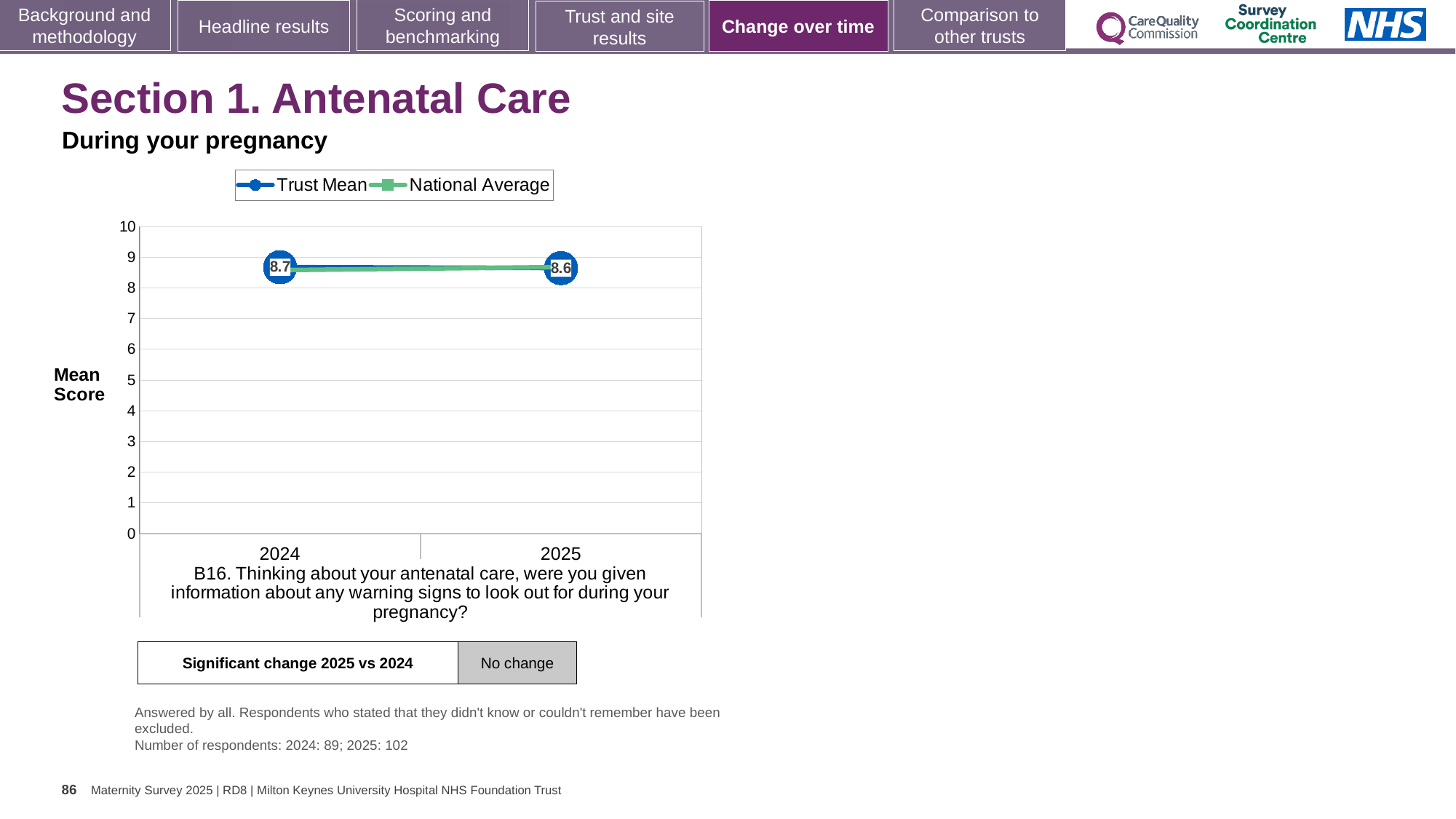
What is the label of the y axis? Mean Score What kind of chart is shown? line chart What is the Trust Mean value for 2024? 8.7 Does the Trust Mean rise or fall from 2024 to 2025? fall What is the difference between the Trust Mean in 2024 and in 2025? 0.1 Which series is shown in green in the legend? National Average Is the National Average for 2024 greater or less than 5? greater What is the Trust Mean value for 2025? 8.6 Is the Trust Mean for 2025 greater or less than 8? greater How many years are shown on the x axis? 2 What is the maximum value shown on the y axis? 10 How many series does the legend list? 2